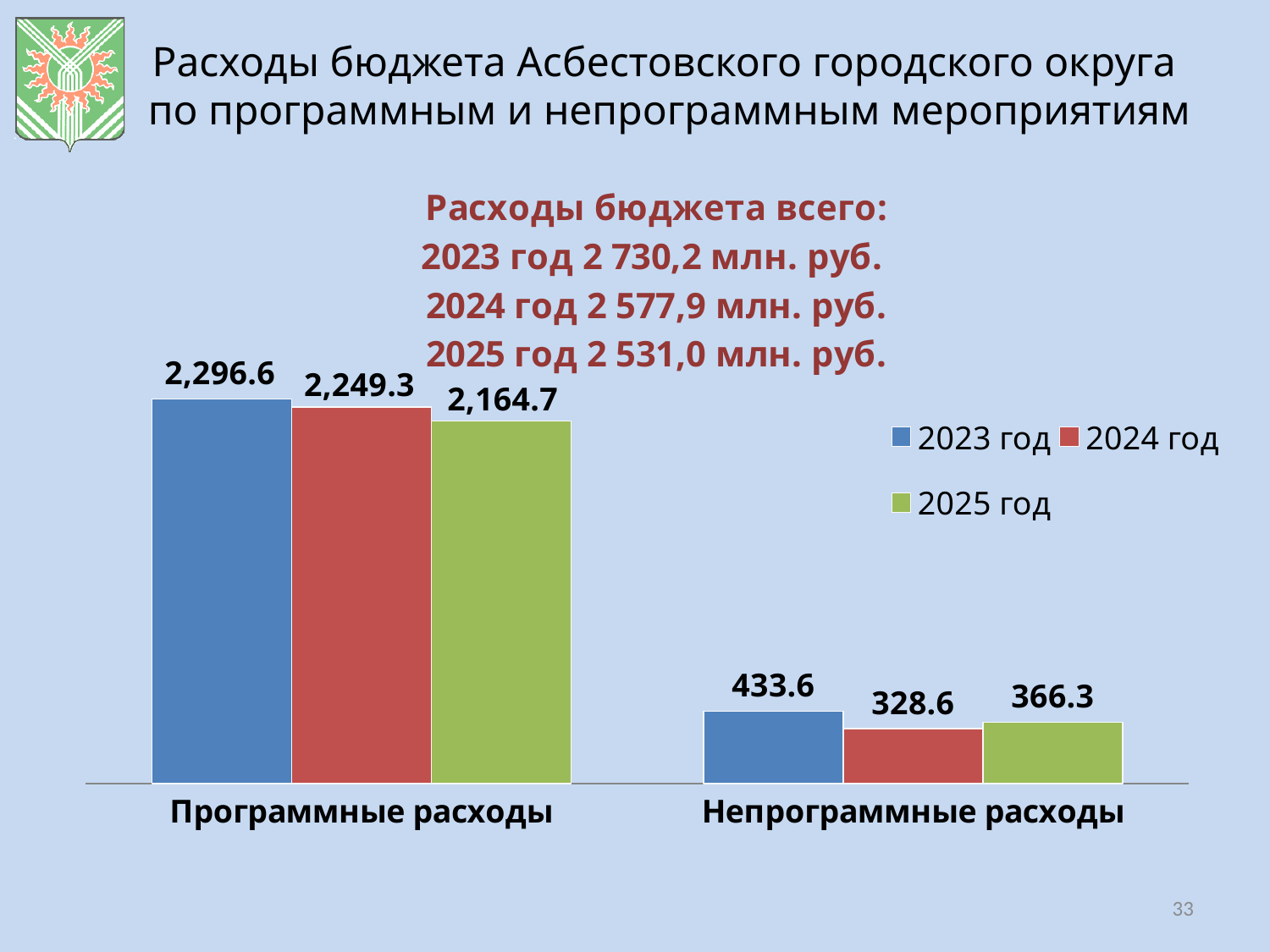
Which year has the lowest value in the Программные расходы category? 2025 год Do the values for Программные расходы rise or fall from 2023 год to 2025 год? Fall Which is larger for Непрограммные расходы: the 2024 год value or the 2025 год value? 2025 год What is the difference between the 2023 год and 2024 год values for Непрограммные расходы? 105.0 What is the value for 2023 год in the Программные расходы category? 2,296.6 What kind of chart is shown on the slide? Bar chart What is the value for 2025 год in the Программные расходы category? 2,164.7 What is the value for 2024 год in the Непрограммные расходы category? 328.6 Which year has the highest value in the Непрограммные расходы category? 2023 год What is the difference between the 2023 год and 2024 год values for Программные расходы? 47.3 How many series does the legend list? 3 What is the value for 2025 год in the Непрограммные расходы category? 366.3